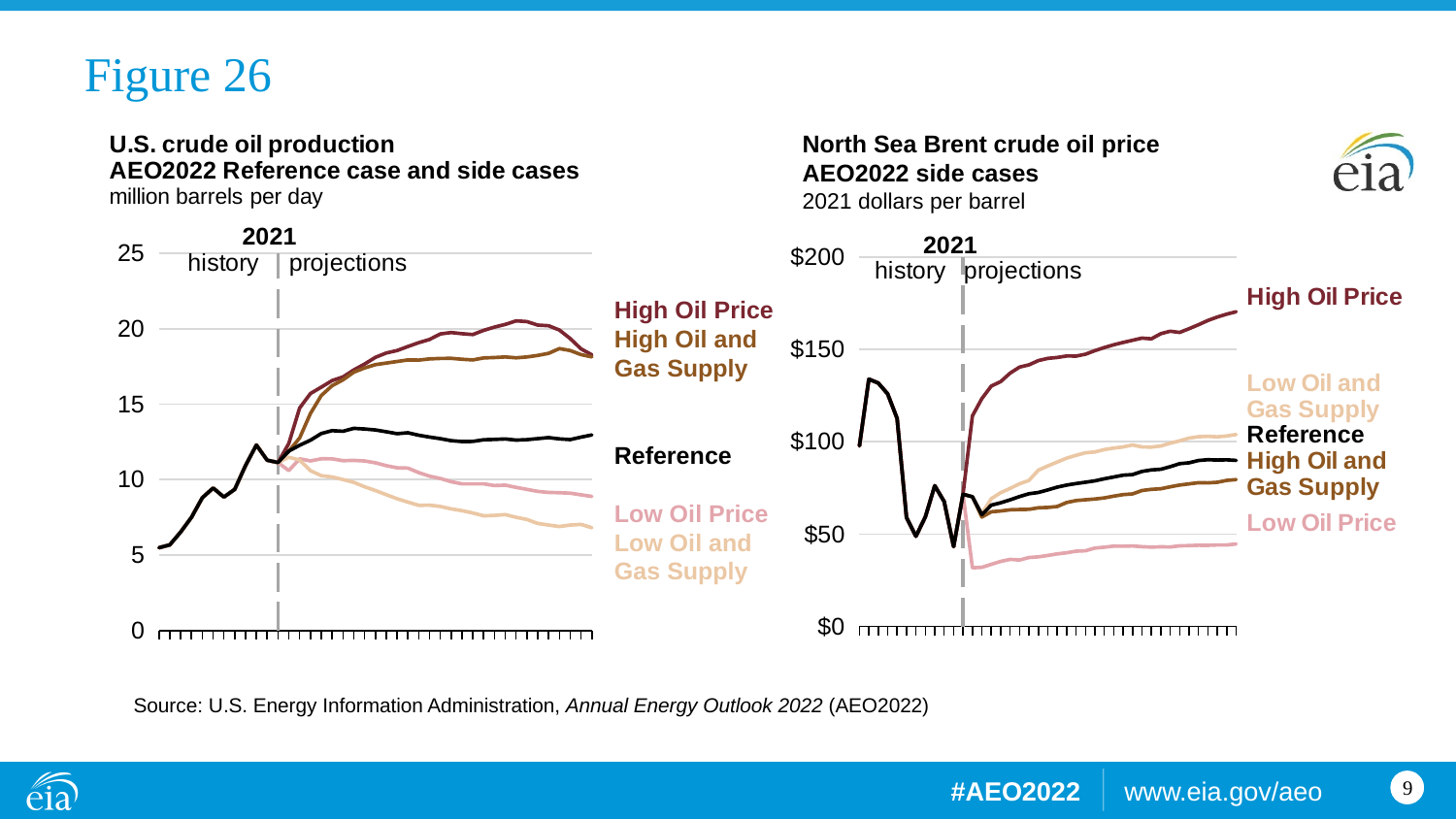
In the U.S. crude oil production chart, is the Reference case value at the end of the projections greater or less than 10 million barrels per day? greater In the U.S. crude oil production chart, which case has the lowest production at the end of the projection period? Low Oil and Gas Supply In the North Sea Brent crude oil price chart, is the High Oil Price value at the end of the projections greater or less than $150? greater In the North Sea Brent crude oil price chart, which case has the highest price at the end of the projection period? High Oil Price What unit is used on the North Sea Brent crude oil price chart? 2021 dollars per barrel What kind of chart is the U.S. crude oil production chart on the left? line chart In the U.S. crude oil production chart, does the Low Oil Price case rise or fall over the projection period? fall In the U.S. crude oil production chart, is the Low Oil and Gas Supply value at the end of the projections greater or less than 10 million barrels per day? less How many cases (series) are labeled on the North Sea Brent crude oil price chart? 5 In the North Sea Brent crude oil price chart, at the end of the projections, which is higher: the Reference case or the High Oil and Gas Supply case? Reference In the North Sea Brent crude oil price chart, which case has the lowest price at the end of the projection period? Low Oil Price